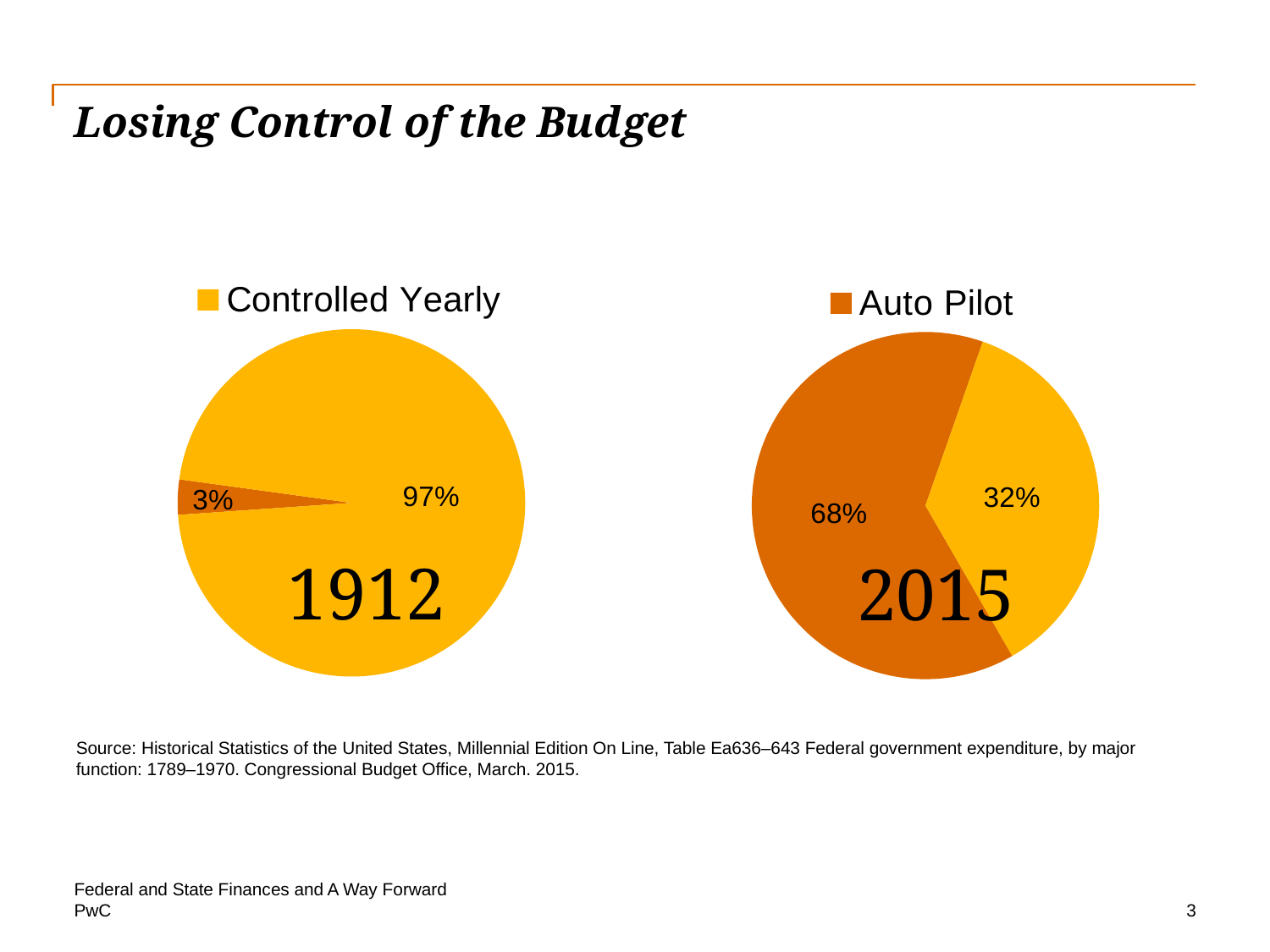
In the 1912 pie chart, what percentage is shown for the small orange slice? 3% In the 2015 pie chart, what percentage is shown for the Auto Pilot slice? 68% How many slices does the 2015 pie chart have? 2 What kind of chart is used for the 1912 and 2015 data? Pie chart In the 1912 pie chart, which slice is the largest? Controlled Yearly (97%) In the 2015 pie chart, which slice is the smallest? 32% What is the title of the slide containing the two pie charts? Losing Control of the Budget In the 2015 pie chart, what is the difference between the two slices' percentages? 36% In the 1912 pie chart, what share is labelled 97%? Controlled Yearly In the 2015 pie chart, what percentage is shown for the yellow slice? 32% How many entries does the legend above the 2015 pie chart list? 1 In the 2015 pie chart, which slice is larger, the 68% slice or the 32% slice? 68%